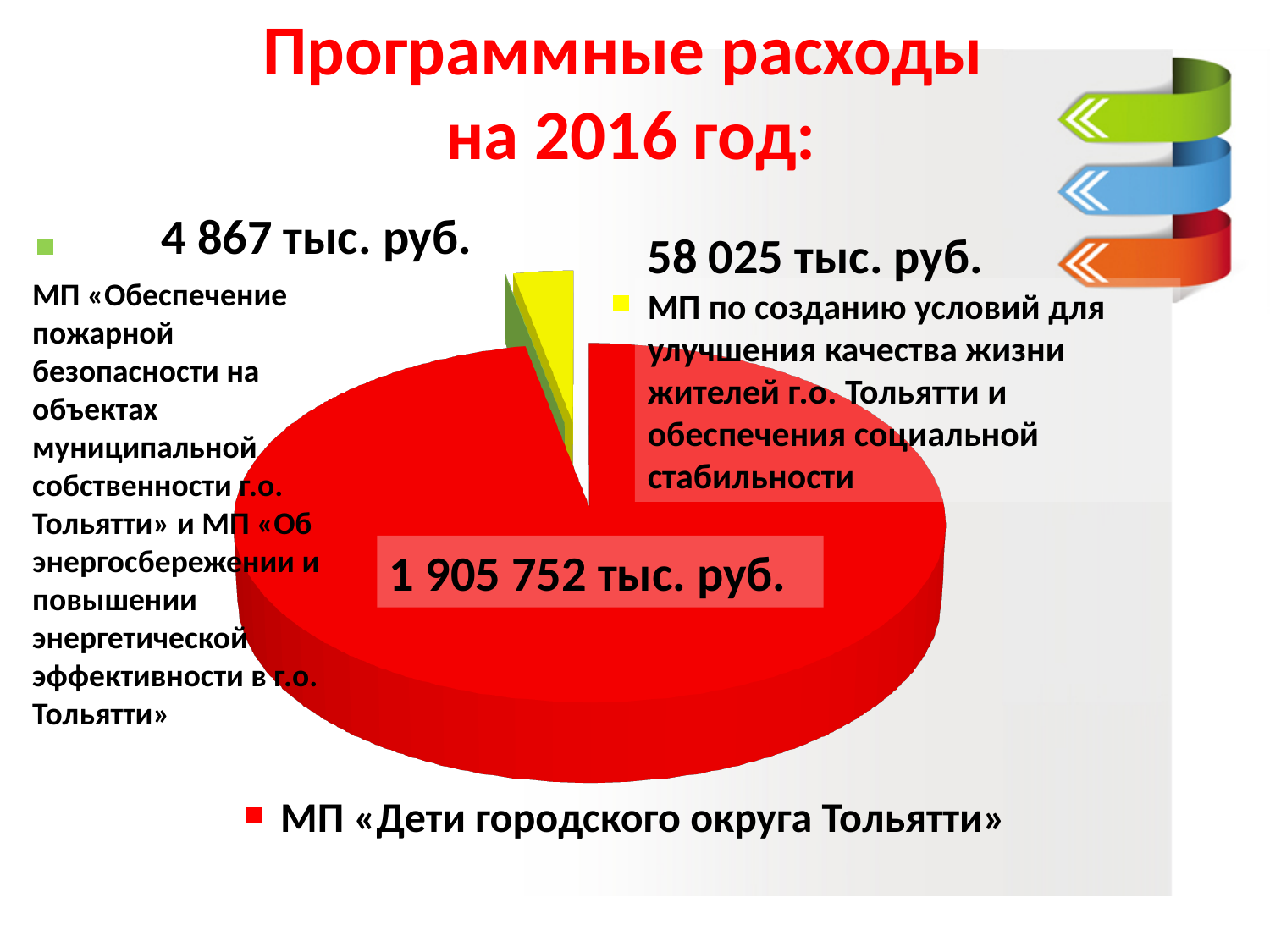
What colour is the slice for МП «Дети городского округа Тольятти»? Red Which slice of the pie chart is the smallest? МП «Обеспечение пожарной безопасности...» и МП «Об энергосбережении...» (4 867 тыс. руб.) What is the value shown for МП по созданию условий для улучшения качества жизни жителей г.о. Тольятти и обеспечения социальной стабильности? 58 025 тыс. руб. How many slices does the pie chart have? 3 What is the difference between the value for МП «Дети городского округа Тольятти» and the value for МП по созданию условий для улучшения качества жизни? 1 847 727 тыс. руб. Which programme has the largest share of the pie chart? МП «Дети городского округа Тольятти» What is the difference between the value for МП по созданию условий для улучшения качества жизни and the value for the fire safety and energy efficiency programmes? 53 158 тыс. руб. What is the value shown for МП «Обеспечение пожарной безопасности...» и МП «Об энергосбережении...»? 4 867 тыс. руб. What is the total of all three values shown in the pie chart? 1 968 644 тыс. руб. What kind of chart is shown on the slide? Pie chart Which is larger: the value for МП по созданию условий для улучшения качества жизни or the value for the fire safety and energy efficiency programmes? МП по созданию условий для улучшения качества жизни What is the value shown for МП «Дети городского округа Тольятти» in the pie chart? 1 905 752 тыс. руб.